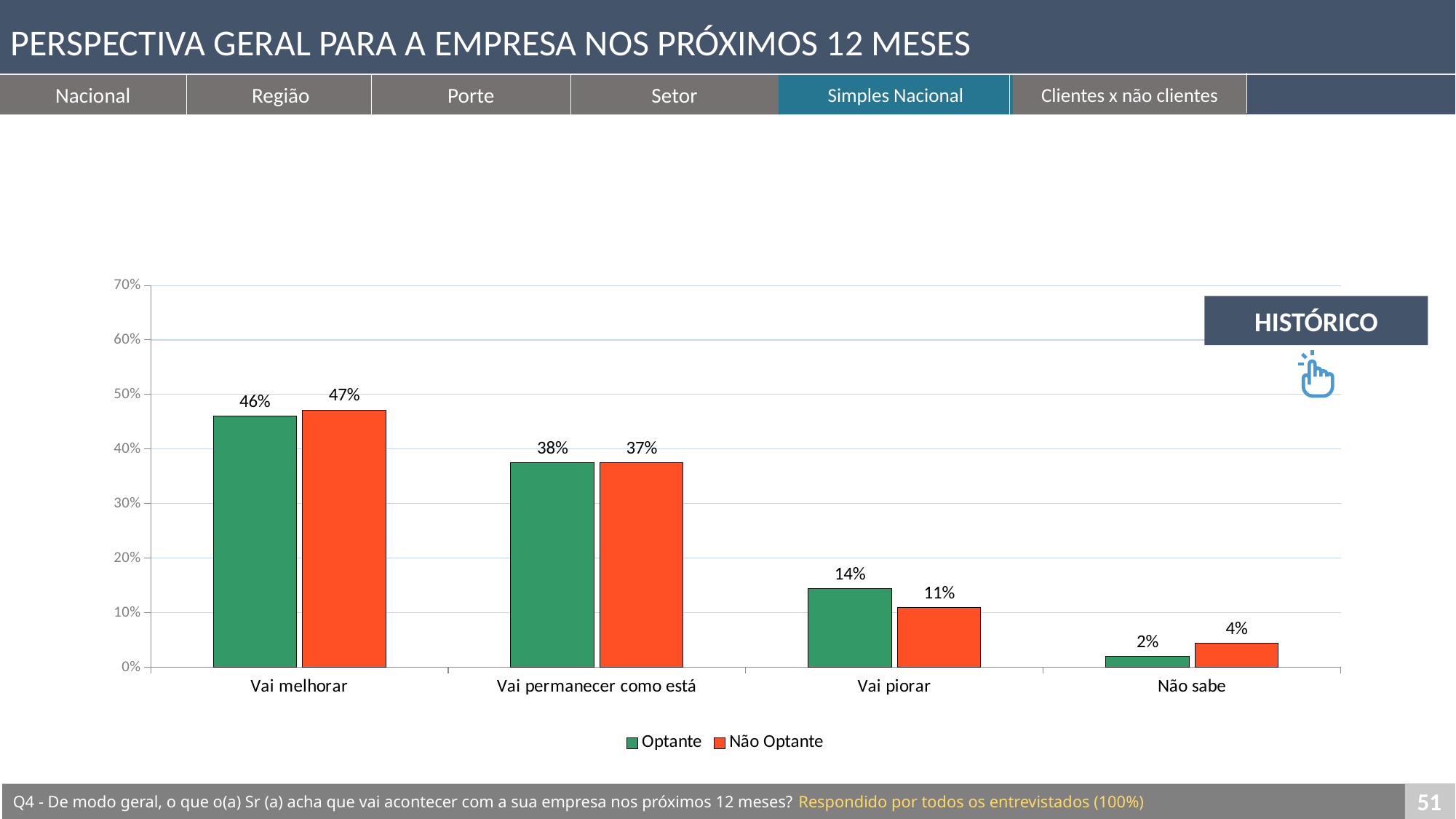
How many categories are shown on the x axis? 4 Is the value for Optante in 'Vai permanecer como está' greater or less than 30%? greater In the 'Não sabe' category, which series has the larger value, Optante or Não Optante? Não Optante Which colour represents the Não Optante series in the legend? Orange What is the value for Optante in the 'Vai melhorar' category? 46% What is the value for Não Optante in the 'Vai piorar' category? 11% What kind of chart is shown on the slide? Bar chart What is the value for Não Optante in the 'Não sabe' category? 4% What is the difference between Optante and Não Optante in the 'Vai piorar' category? 3% How many series does the legend list? 2 Which category has the lowest value for the Não Optante series? Não sabe Which category has the highest value for the Optante series? Vai melhorar